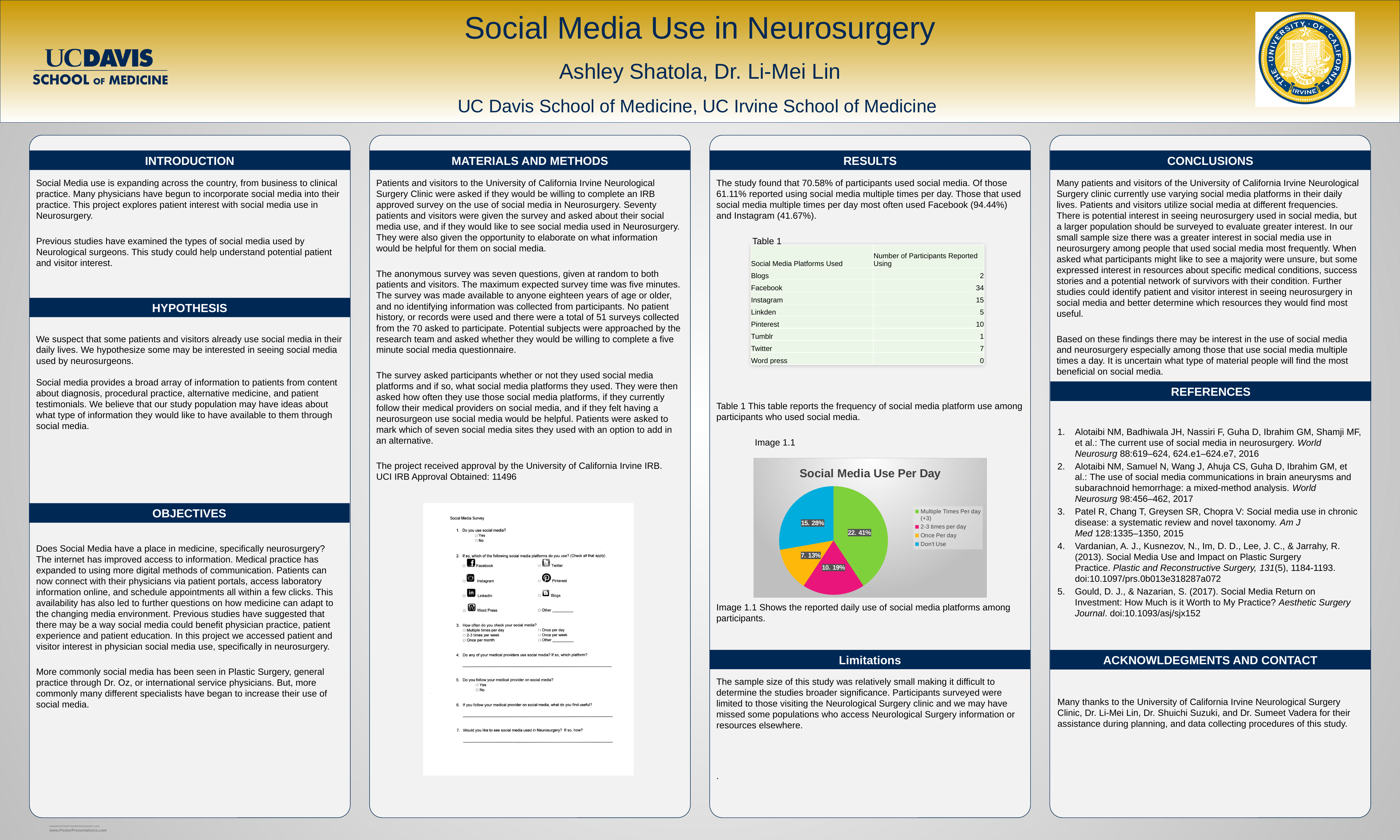
Which category has the smallest slice in the Social Media Use Per Day pie chart? Once Per day How many entries does the legend of the Social Media Use Per Day pie chart list? 4 In the Social Media Use Per Day pie chart, what data label is shown on the 2-3 times per day slice? 10. 19% In the Social Media Use Per Day pie chart, what data label is shown on the Don't Use slice? 15. 28% In the Social Media Use Per Day pie chart, what colour is the Multiple Times Per day (+3) slice? green What is the title of the pie chart in Image 1.1? Social Media Use Per Day What kind of chart is Image 1.1 on the slide? pie chart Which category has the largest slice in the Social Media Use Per Day pie chart? Multiple Times Per day (+3) In the Social Media Use Per Day pie chart, which slice is larger: Don't Use or 2-3 times per day? Don't Use In the Social Media Use Per Day pie chart, what data label is shown on the Multiple Times Per day (+3) slice? 22. 41% How many slices does the Social Media Use Per Day pie chart have? 4 In the Social Media Use Per Day pie chart, what data label is shown on the Once Per day slice? 7. 13%